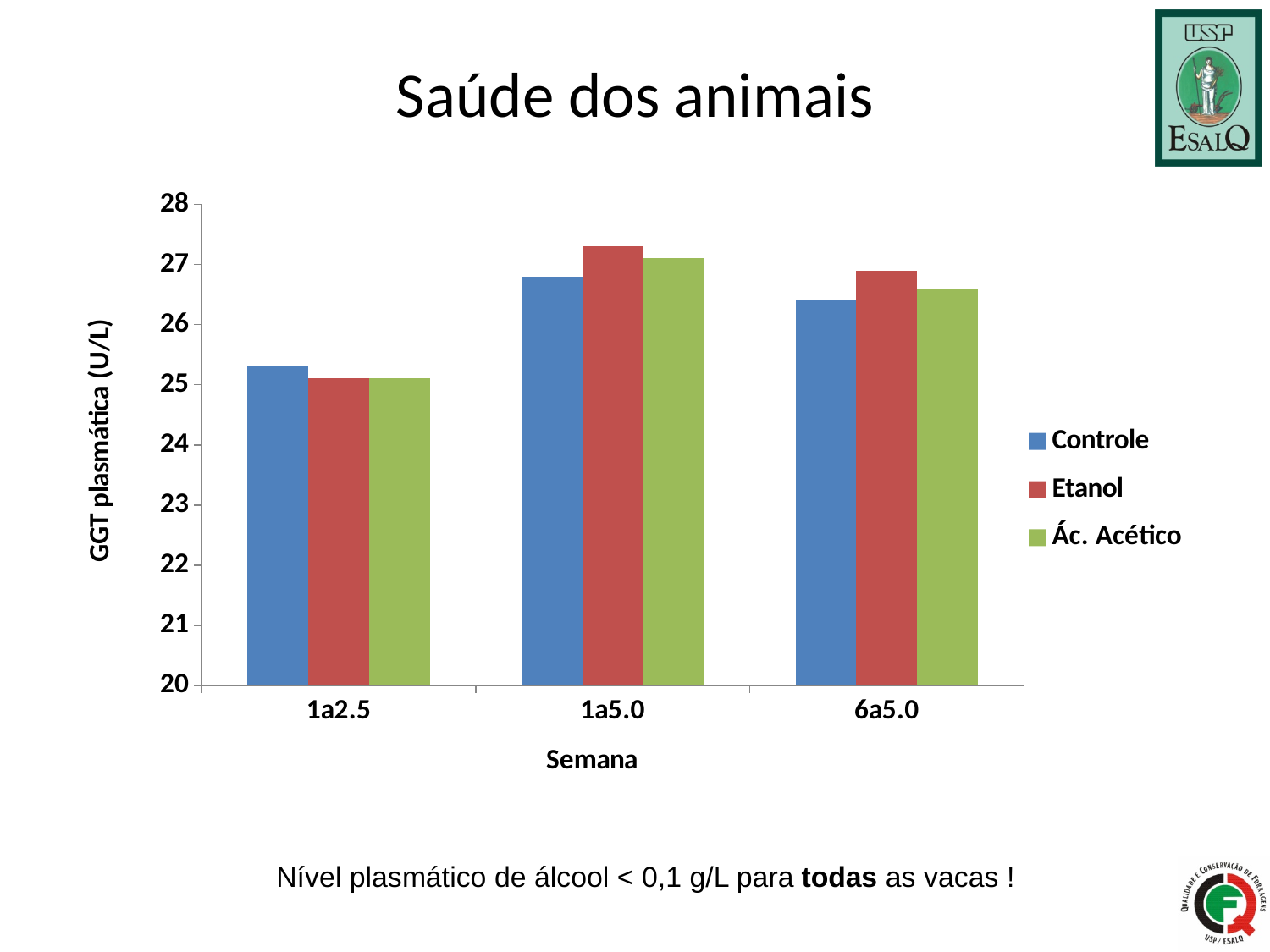
Is the value for Controle at 1a5.0 greater or less than 27? less Which category (Semana) has the lowest values for all three series? 1a2.5 Is the value for Controle at 1a2.5 greater or less than 25? greater Is the value for Etanol at 1a5.0 greater or less than 27? greater Which is larger: the Controle value at 1a5.0 or the Controle value at 6a5.0? 1a5.0 What is the title of the y axis? GGT plasmática (U/L) What is the title of the x axis? Semana How many categories are shown on the x axis? 3 How many series does the legend list? 3 Which series has the highest bar at 6a5.0? Etanol What kind of chart is shown on the slide? bar chart